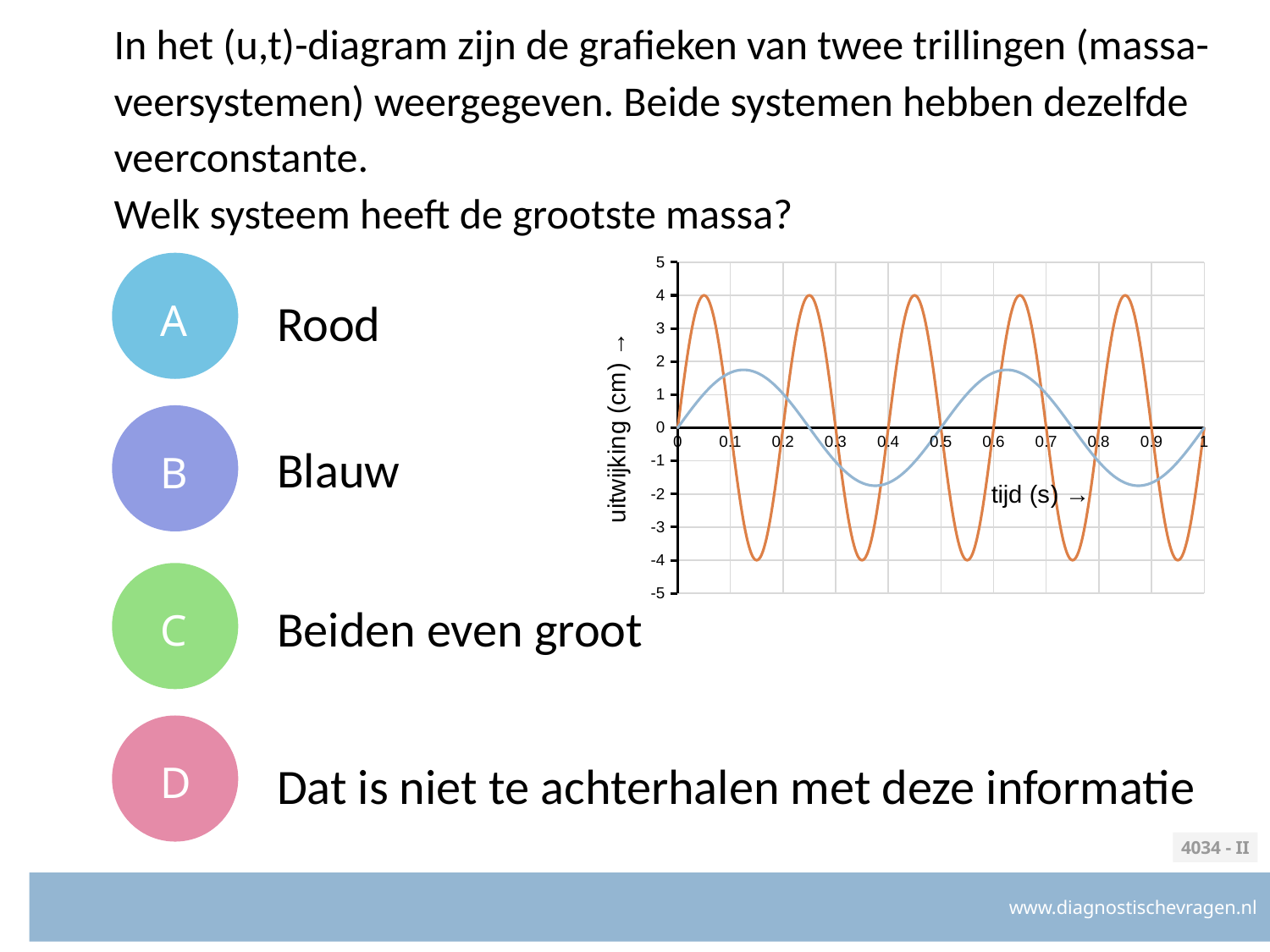
Is the peak value of the blue line greater or less than 2? less What kind of chart is shown on the slide? line chart How many lines (series) are plotted in the chart? 2 Which line reaches the higher peak value, the orange line or the blue line? orange What is the label of the vertical axis of the chart? uitwijking (cm) How many peaks (maxima) does the orange line show between t = 0 and t = 1 s? 5 Is the peak value of the blue line greater or less than 1? greater What is the label of the horizontal axis of the chart? tijd (s) What is the highest value shown on the vertical axis of the chart? 5 How many peaks (maxima) does the blue line show between t = 0 and t = 1 s? 2